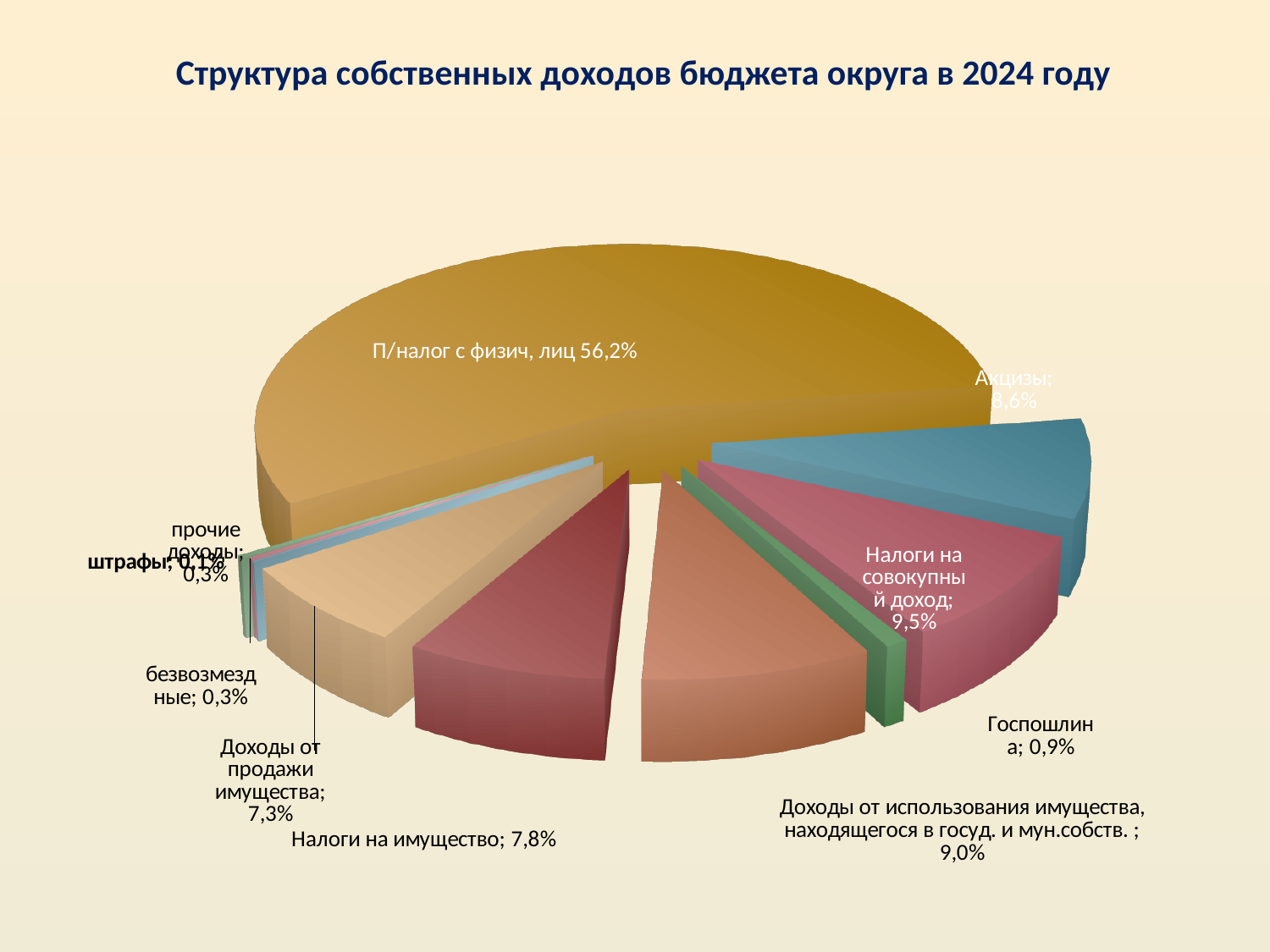
What is the value shown for "Налоги на имущество"? 7,8% What is the title of the chart? Структура собственных доходов бюджета округа в 2024 году What is the difference between the values for "Налоги на имущество" and "Доходы от продажи имущества"? 0,5% Which category has the largest share of the pie? П/налог с физич. лиц Which is larger: "Налоги на совокупный доход" or "Акцизы"? Налоги на совокупный доход What is the value shown for "Госпошлина"? 0,9% What kind of chart is shown on the slide? pie chart What share of the pie does "П/налог с физич. лиц" have? 56,2% What is the value shown for "Налоги на совокупный доход"? 9,5% What is the value shown for "Доходы от продажи имущества"? 7,3% What is the value shown for "Акцизы"? 8,6% Which category has the smallest share of the pie? штрафы